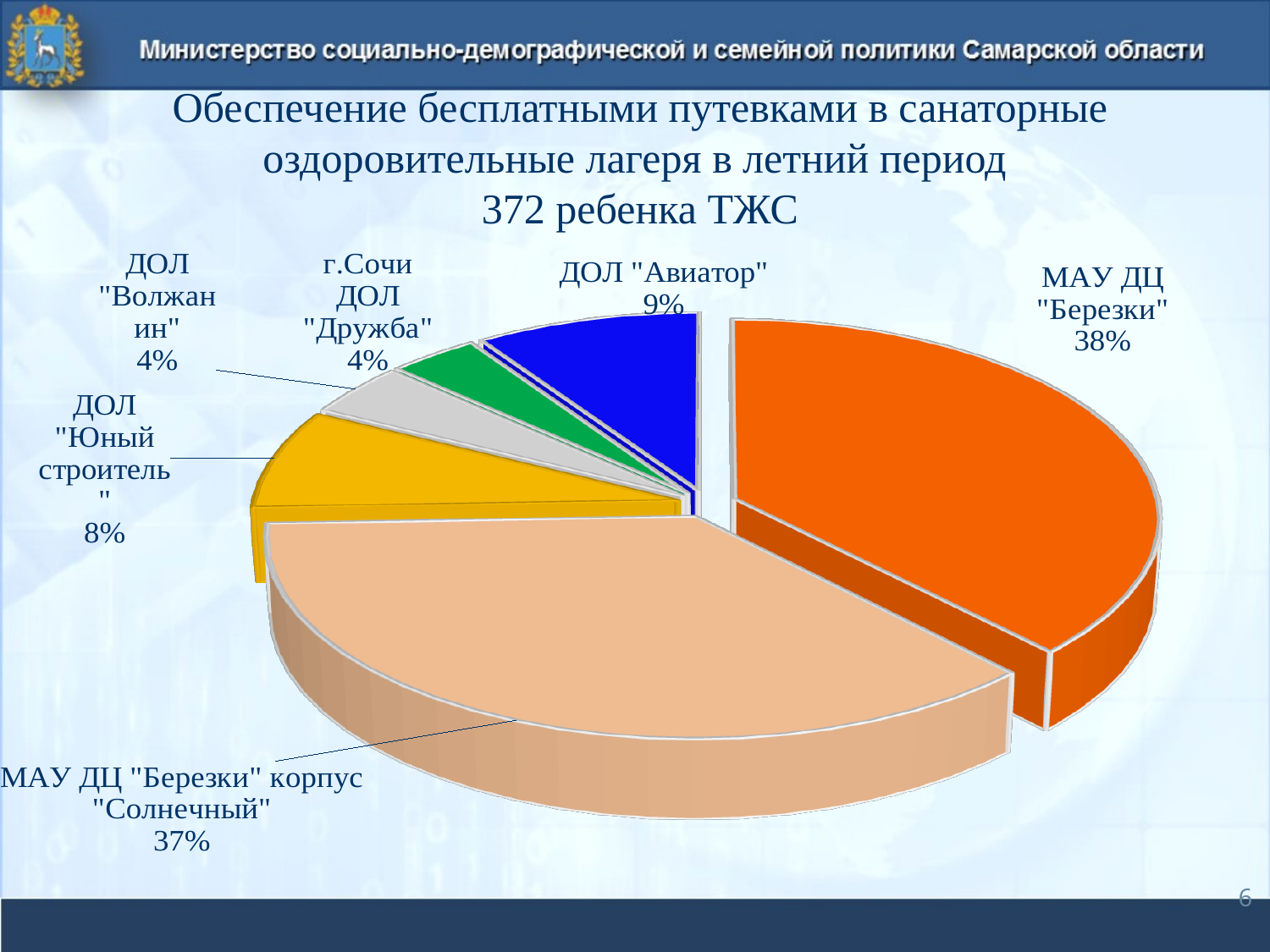
Which is larger, the share of ДОЛ "Авиатор" or the share of ДОЛ "Юный строитель"? ДОЛ "Авиатор" What is the value shown for ДОЛ "Авиатор"? 9% Which category has the largest share of the pie? МАУ ДЦ "Березки" What share of the pie does МАУ ДЦ "Березки" корпус "Солнечный" hold? 37% What is the value shown for ДОЛ "Юный строитель"? 8% How many children (ТЖС) does the chart title say were provided with free vouchers? 372 What share of the pie does МАУ ДЦ "Березки" hold? 38% What is the difference between the shares of МАУ ДЦ "Березки" and ДОЛ "Авиатор"? 29% What type of chart is shown on the slide? Pie chart What is the combined share of ДОЛ "Волжанин" and г.Сочи ДОЛ "Дружба"? 8% How many slices does the pie chart have? 6 What is the value shown for г.Сочи ДОЛ "Дружба"? 4%